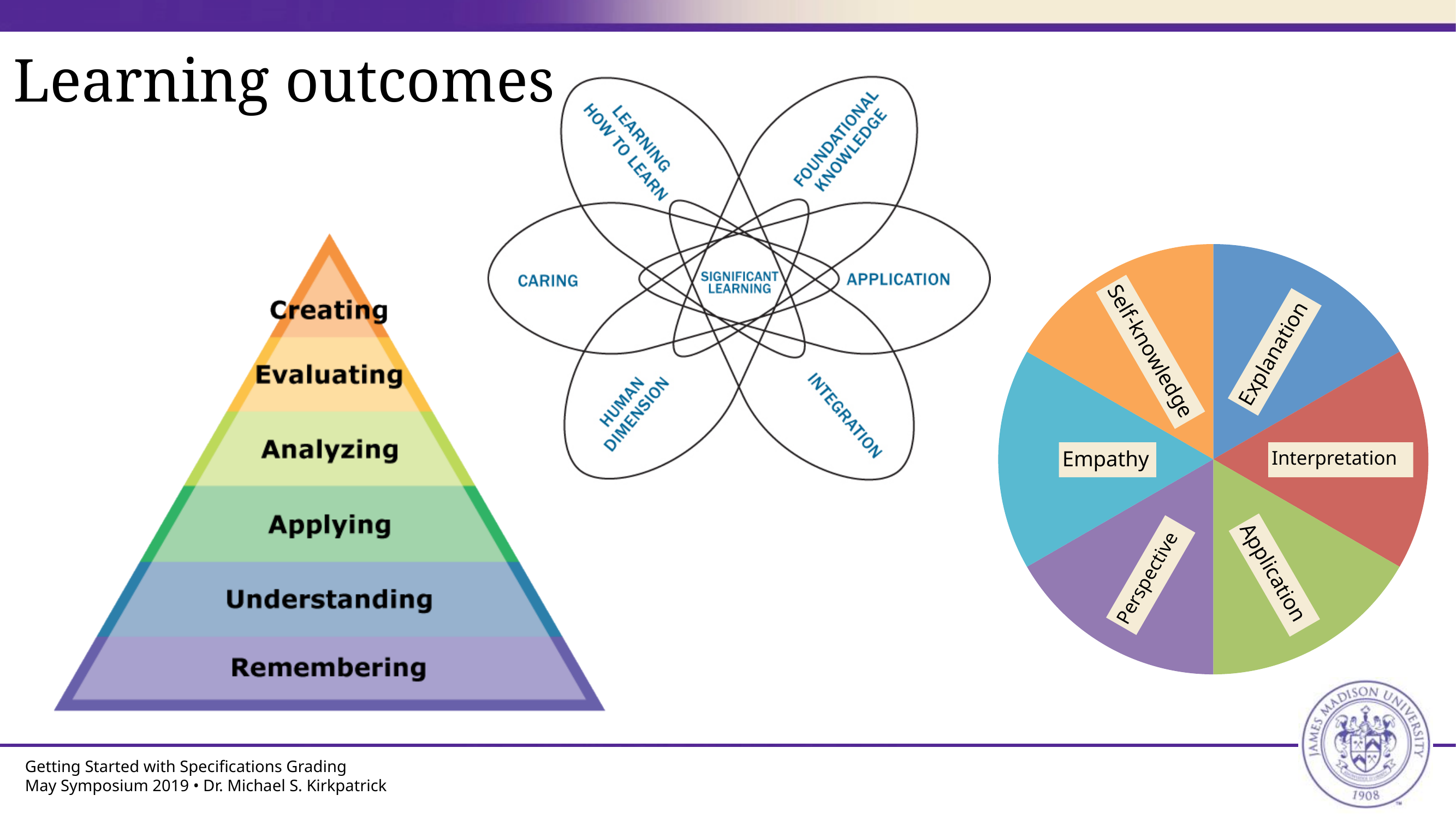
In the pyramid diagram on the left, how many levels are there? 6 In the overlapping-ellipse diagram in the middle, how many outer petals (ellipses) are labelled? 6 In the overlapping-ellipse diagram in the middle, what label is at the centre? Significant Learning What kind of chart is shown on the right side of the slide? pie chart What is the title of the slide? Learning outcomes In the pie chart on the right, which slice is coloured orange? Self-knowledge In the pie chart on the right, how many slices are there? 6 In the pyramid diagram on the left, which level is at the top? Creating In the pyramid diagram on the left, which level is at the bottom? Remembering In the pie chart on the right, what colour is the Interpretation slice? red